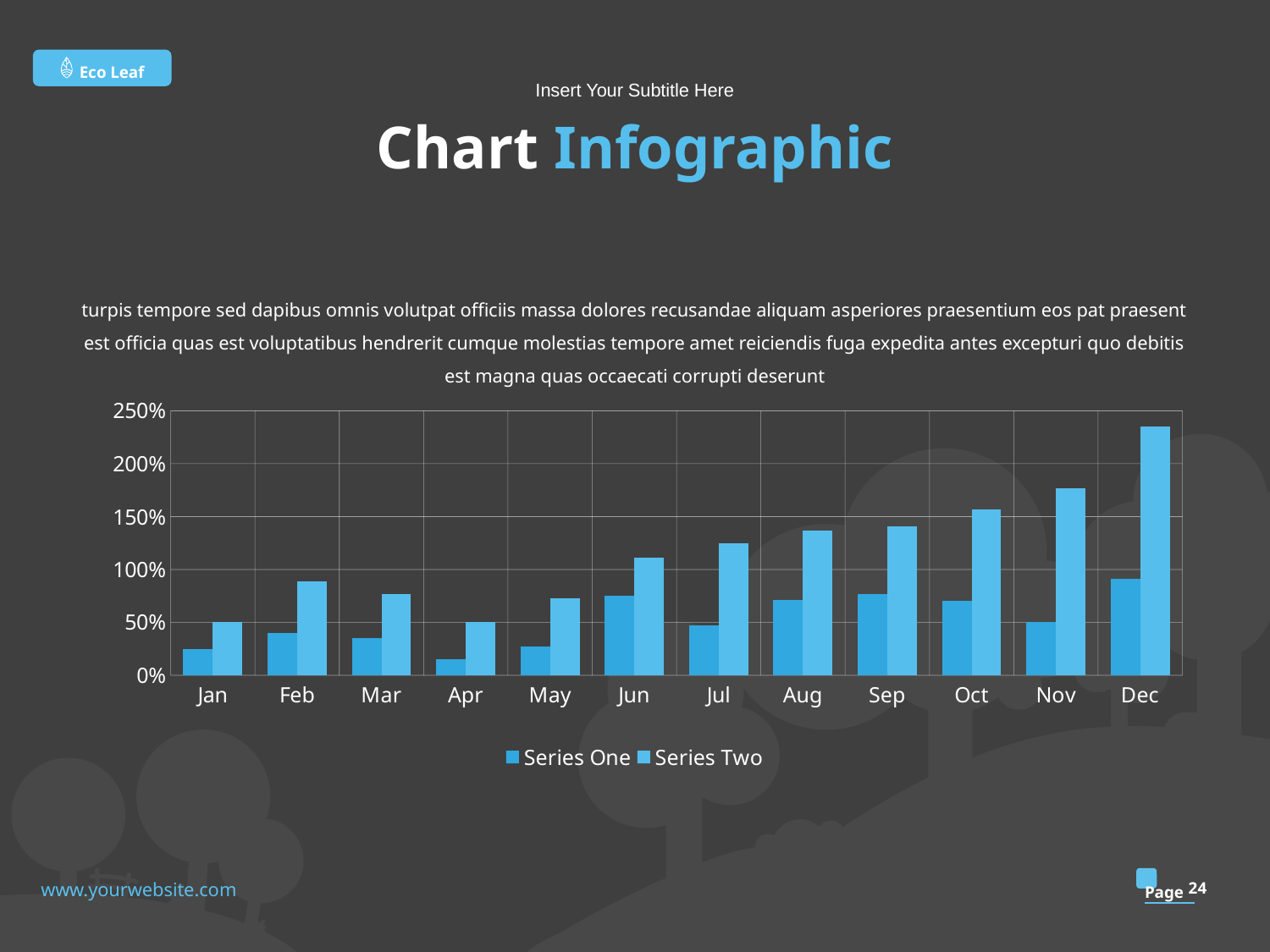
Do the Series Two values generally rise or fall from Jun to Dec? rise Is the value for Series Two in Dec greater or less than 200%? greater Which month has the lowest value for Series One? Apr What kind of chart is shown on the slide? bar chart How many series does the legend list? 2 Which is larger in Nov, Series One or Series Two? Series Two Is the value for Series Two in Oct greater or less than 150%? greater Is the value for Series One in Dec greater or less than 100%? less What are the two legend entries of the chart? Series One, Series Two How many months are shown on the x axis? 12 Which month has the highest value for Series Two? Dec